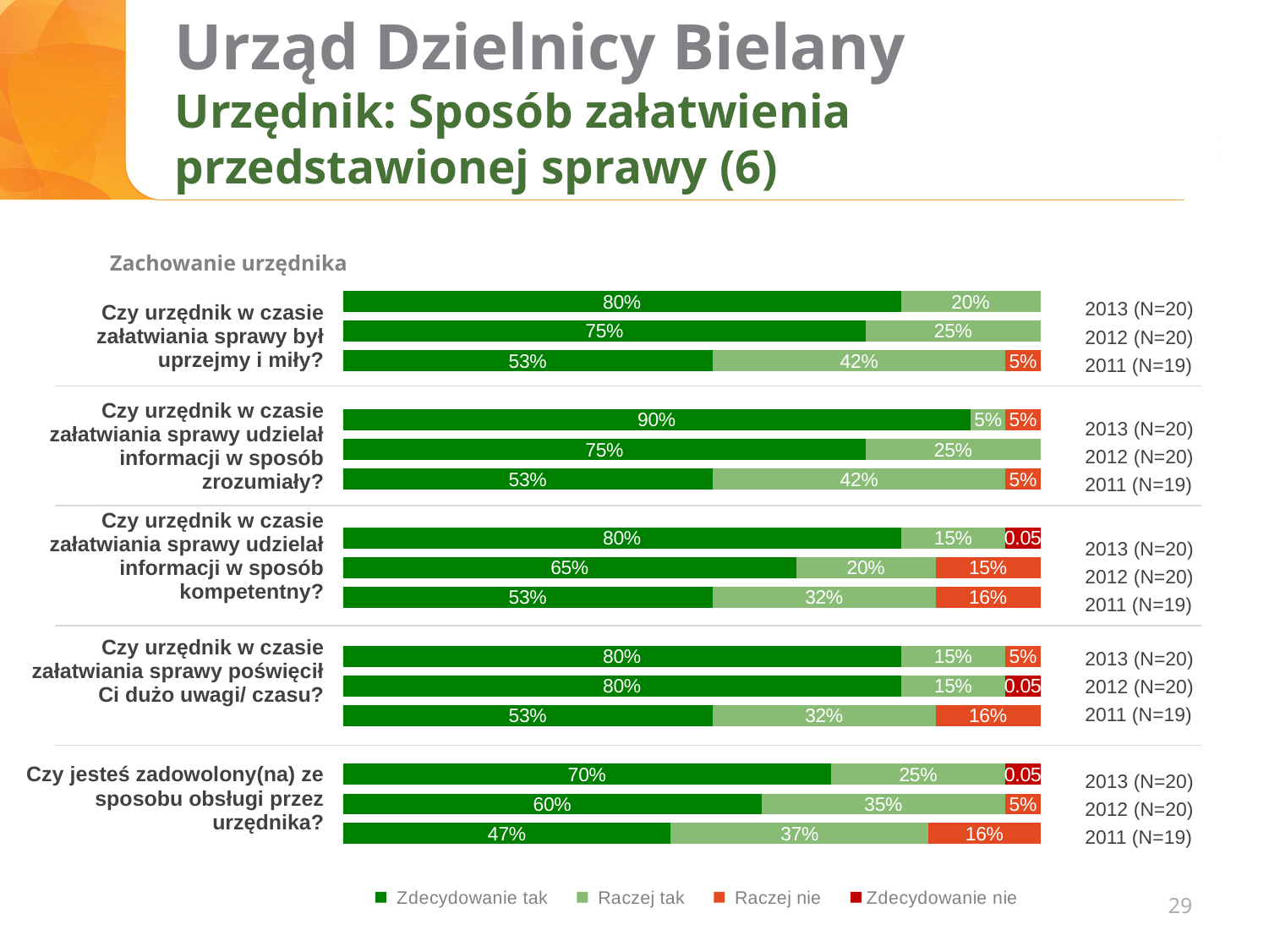
For the question 'Czy urzędnik w czasie załatwiania sprawy udzielał informacji w sposób zrozumiały?', which year has the highest 'Zdecydowanie tak' value? 2013 What is the 'Raczej tak' value for 2011 for the question 'Czy jesteś zadowolony(na) ze sposobu obsługi przez urzędnika?'? 37% How many years (bars) are shown for each question? 3 For the question 'Czy jesteś zadowolony(na) ze sposobu obsługi przez urzędnika?', which year has the larger 'Zdecydowanie tak' value, 2012 or 2011? 2012 What is the first entry in the chart legend? Zdecydowanie tak For the question 'Czy urzędnik w czasie załatwiania sprawy udzielał informacji w sposób kompetentny?', what is the difference between the 'Zdecydowanie tak' values for 2013 and 2011? 27 percentage points What kind of chart is shown on the slide? Stacked bar chart How many series does the legend list? 4 What is the 'Raczej nie' value for 2011 for the question 'Czy urzędnik w czasie załatwiania sprawy poświęcił Ci dużo uwagi/ czasu?'? 16% What is the 'Zdecydowanie tak' value for 2013 for the question 'Czy urzędnik w czasie załatwiania sprawy był uprzejmy i miły?'? 80% For the question 'Czy jesteś zadowolony(na) ze sposobu obsługi przez urzędnika?', does the 'Zdecydowanie tak' value rise or fall from 2011 to 2013? Rise What is the sample size (N) shown for 2011? N=19